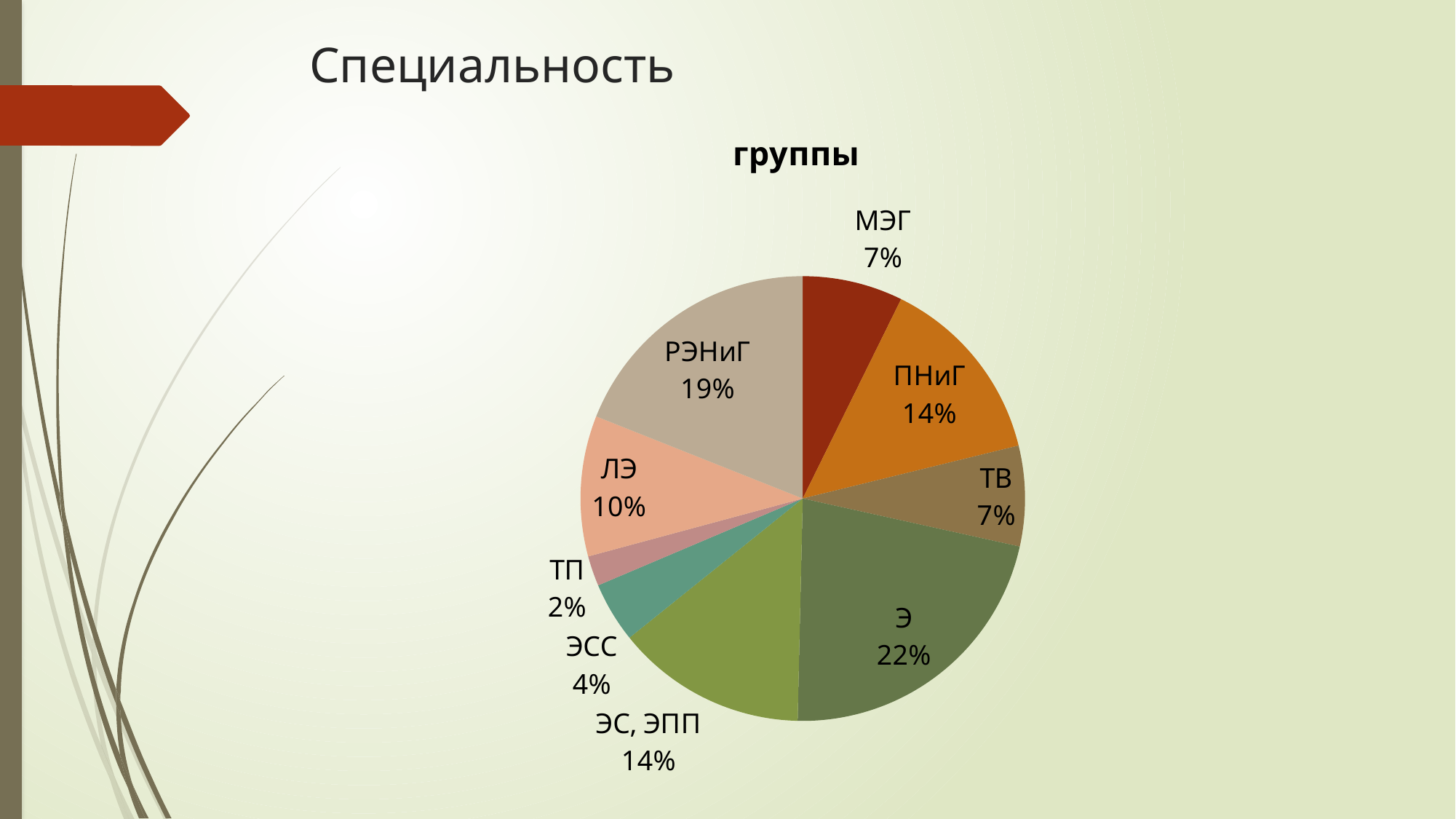
What is the value for ЭС, ЭПП? 14% What is the difference between the shares of ПНиГ and ТВ? 7% What is the value for РЭНиГ? 19% What is the value for ЛЭ? 10% How many slices does the pie chart have? 9 Which category has the smallest slice? ТП Which category has the largest slice? Э What is the title of the chart? группы What share of the pie does Э have? 22% What kind of chart is shown on the slide? pie chart Which is larger, ЛЭ or ЭСС? ЛЭ What is the difference between the shares of Э and РЭНиГ? 3%